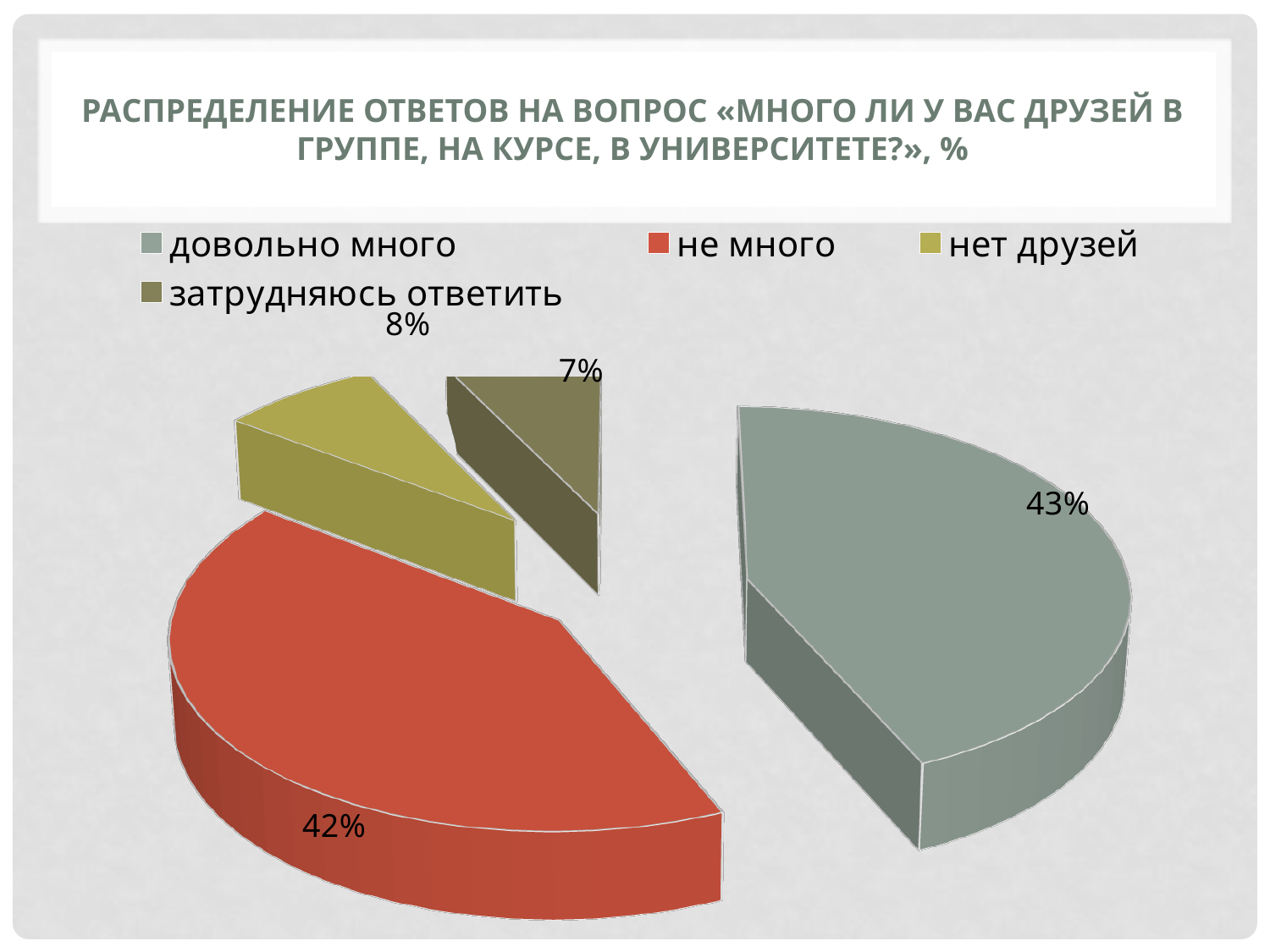
How many slices does the pie chart have? 4 What is the difference in percentage points between «довольно много» and «не много»? 1 What type of chart is shown on the slide? pie chart What percentage of respondents answered «нет друзей»? 8% What percentage of respondents answered «не много»? 42% What colour is the slice for «не много»? red Which is larger: the share for «нет друзей» or the share for «затрудняюсь ответить»? нет друзей Which answer option has the smallest share of the pie? затрудняюсь ответить What percentage of respondents answered «довольно много»? 43% Which answer option has the largest share of the pie? довольно много What is the difference in percentage points between «нет друзей» and «затрудняюсь ответить»? 1 What percentage of respondents answered «затрудняюсь ответить»? 7%